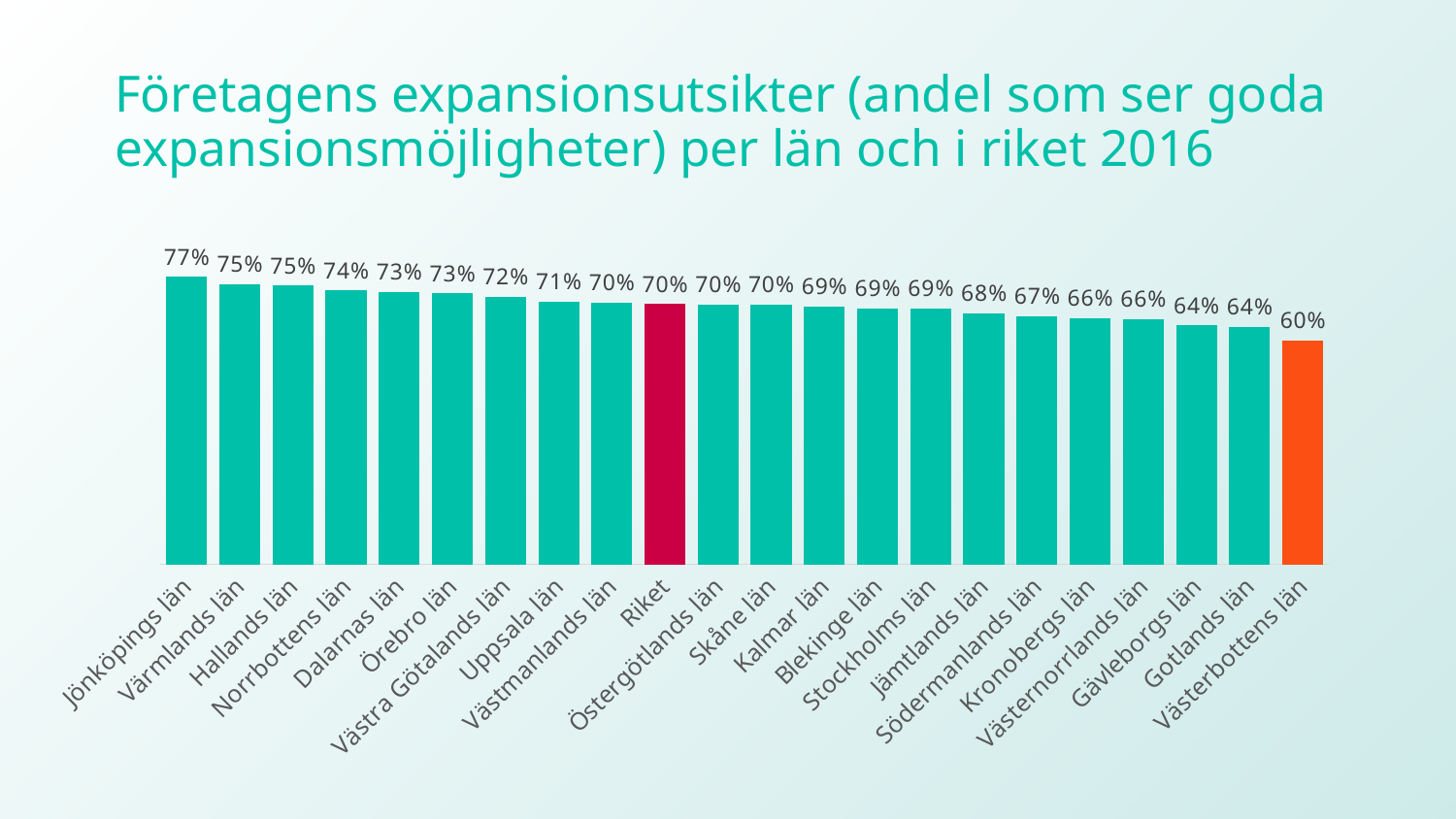
Which category has the highest value? Jönköpings län Which bar is coloured orange? Västerbottens län How many bars are shown in the chart? 22 What is the value for Gotlands län? 64% What is the value for Riket? 70% Which category has the lowest value? Västerbottens län What kind of chart is shown on the slide? Bar chart What is the value for Jönköpings län? 77% What is the difference between the values for Jönköpings län and Västerbottens län? 17 percentage points Which is larger, the value for Norrbottens län or the value for Kronobergs län? Norrbottens län What is the difference between the values for Riket and Jämtlands län? 2 percentage points What is the value for Stockholms län? 69%